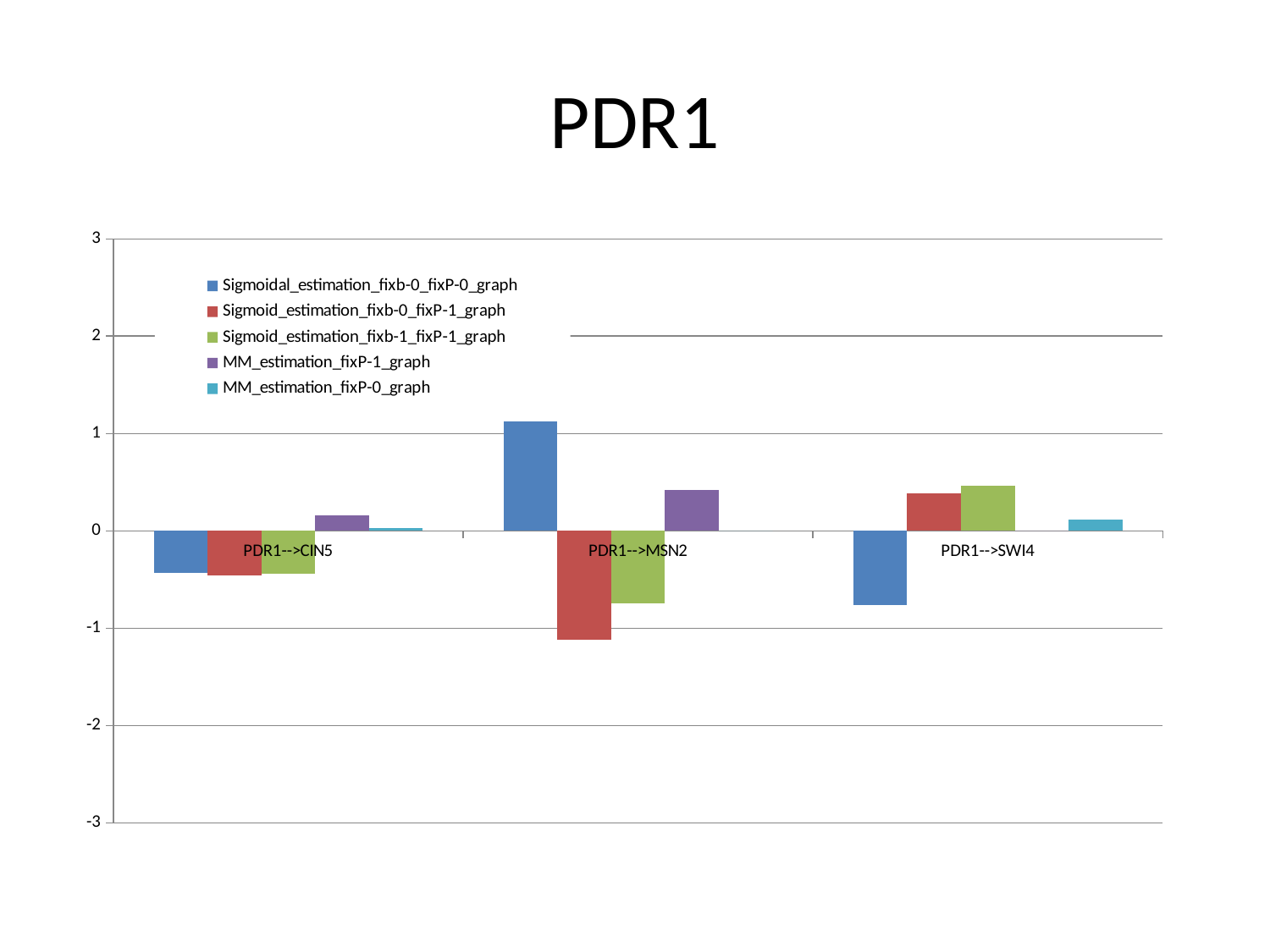
Is the value of MM_estimation_fixP-1_graph for PDR1-->MSN2 greater or less than 1? less For which category is the Sigmoidal_estimation_fixb-0_fixP-0_graph value highest? PDR1-->MSN2 Which series is shown in blue in the chart's legend? Sigmoidal_estimation_fixb-0_fixP-0_graph Which series has the lowest value for PDR1-->MSN2? Sigmoid_estimation_fixb-0_fixP-1_graph How many series does the chart's legend list? 5 Is the value of Sigmoid_estimation_fixb-0_fixP-1_graph for PDR1-->MSN2 greater or less than -1? less Is the value of Sigmoidal_estimation_fixb-0_fixP-0_graph for PDR1-->SWI4 greater or less than 0? less For PDR1-->SWI4, which is larger: the Sigmoid_estimation_fixb-1_fixP-1_graph value or the Sigmoid_estimation_fixb-0_fixP-1_graph value? Sigmoid_estimation_fixb-1_fixP-1_graph How many categories are shown on the x axis of the chart? 3 What kind of chart is shown on the slide? bar chart What is the title of the slide containing the chart? PDR1